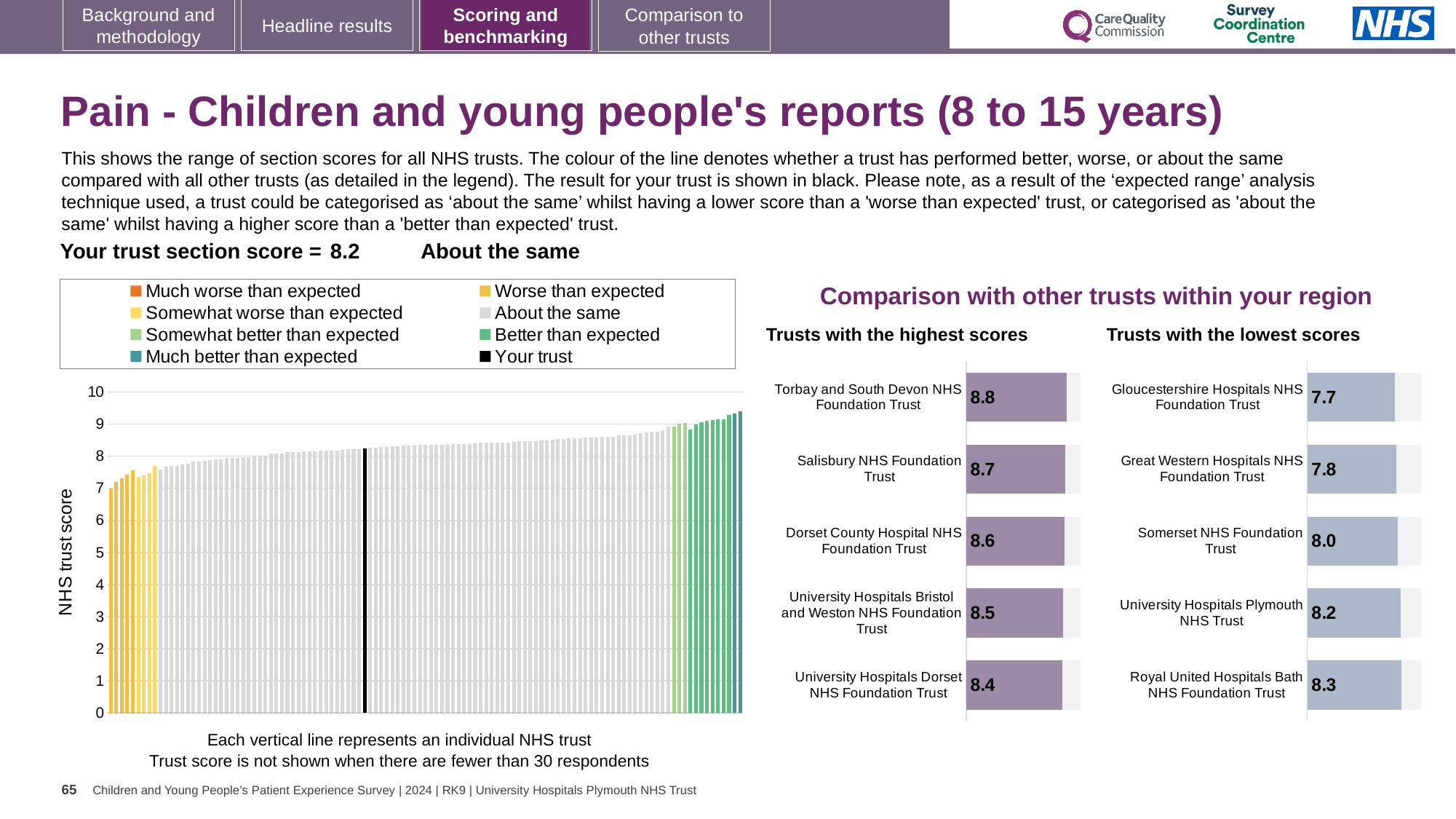
In the 'Trusts with the lowest scores' chart, which trust has the lowest score? Gloucestershire Hospitals NHS Foundation Trust In the 'Trusts with the lowest scores' chart, what is the score for Gloucestershire Hospitals NHS Foundation Trust? 7.7 In the 'Trusts with the highest scores' chart, what is the score for Torbay and South Devon NHS Foundation Trust? 8.8 In the 'Trusts with the highest scores' chart, which trust has the highest score? Torbay and South Devon NHS Foundation Trust In the 'Trusts with the lowest scores' chart, what is the difference between the scores of Royal United Hospitals Bath NHS Foundation Trust and Gloucestershire Hospitals NHS Foundation Trust? 0.6 In the 'NHS trust score' chart, what is the section score for your trust (the black bar)? 8.2 How many trusts are shown in the 'Trusts with the highest scores' chart? 5 In the 'Trusts with the lowest scores' chart, which has the larger score: Somerset NHS Foundation Trust or Great Western Hospitals NHS Foundation Trust? Somerset NHS Foundation Trust What kind of chart is the 'NHS trust score' chart on the left of the slide? Bar chart In the 'NHS trust score' chart, do the bar values rise or fall from left to right? Rise How many entries does the legend of the 'NHS trust score' chart list? 8 In the 'Trusts with the highest scores' chart, what is the difference between the scores of Torbay and South Devon NHS Foundation Trust and University Hospitals Dorset NHS Foundation Trust? 0.4